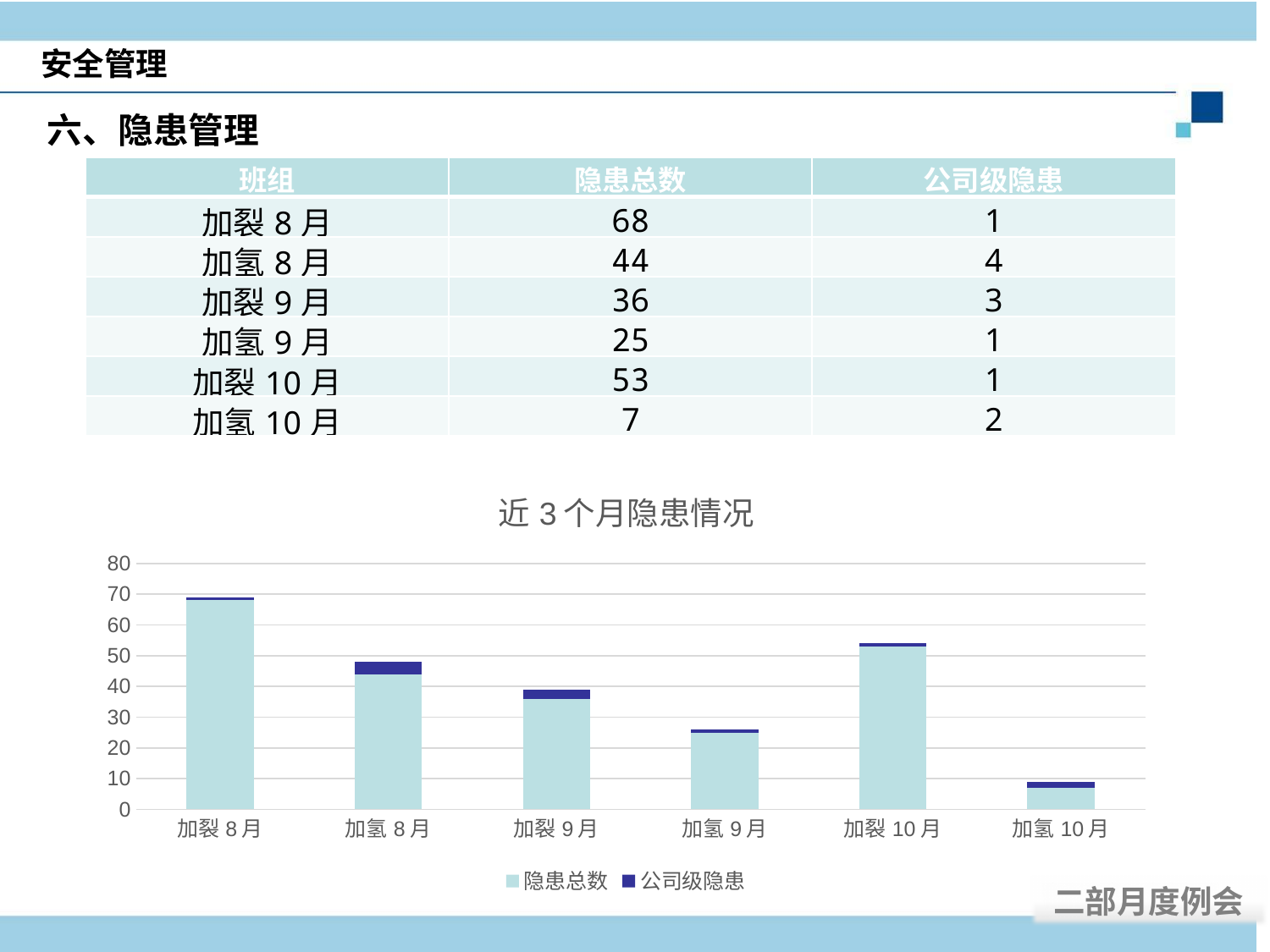
What kind of chart is shown under the title 近3个月隐患情况? bar chart Is the 隐患总数 value for 加裂10月 greater or less than 50? greater Which is larger, the 隐患总数 for 加氢8月 or for 加裂9月? 加氢8月 How many categories are shown on the x axis of the chart? 6 What is the title of the chart? 近3个月隐患情况 How many series does the legend of the chart list? 2 What is the 隐患总数 value for 加裂8月 as printed on the slide? 68 Which category has the lowest 隐患总数 in the chart? 加氢10月 Which category has the highest 隐患总数 in the chart? 加裂8月 What is the difference between the 隐患总数 for 加裂8月 and 加裂9月? 32 What is the 公司级隐患 value for 加氢8月 as printed on the slide? 4 Is the 隐患总数 value for 加氢9月 greater or less than 30? less